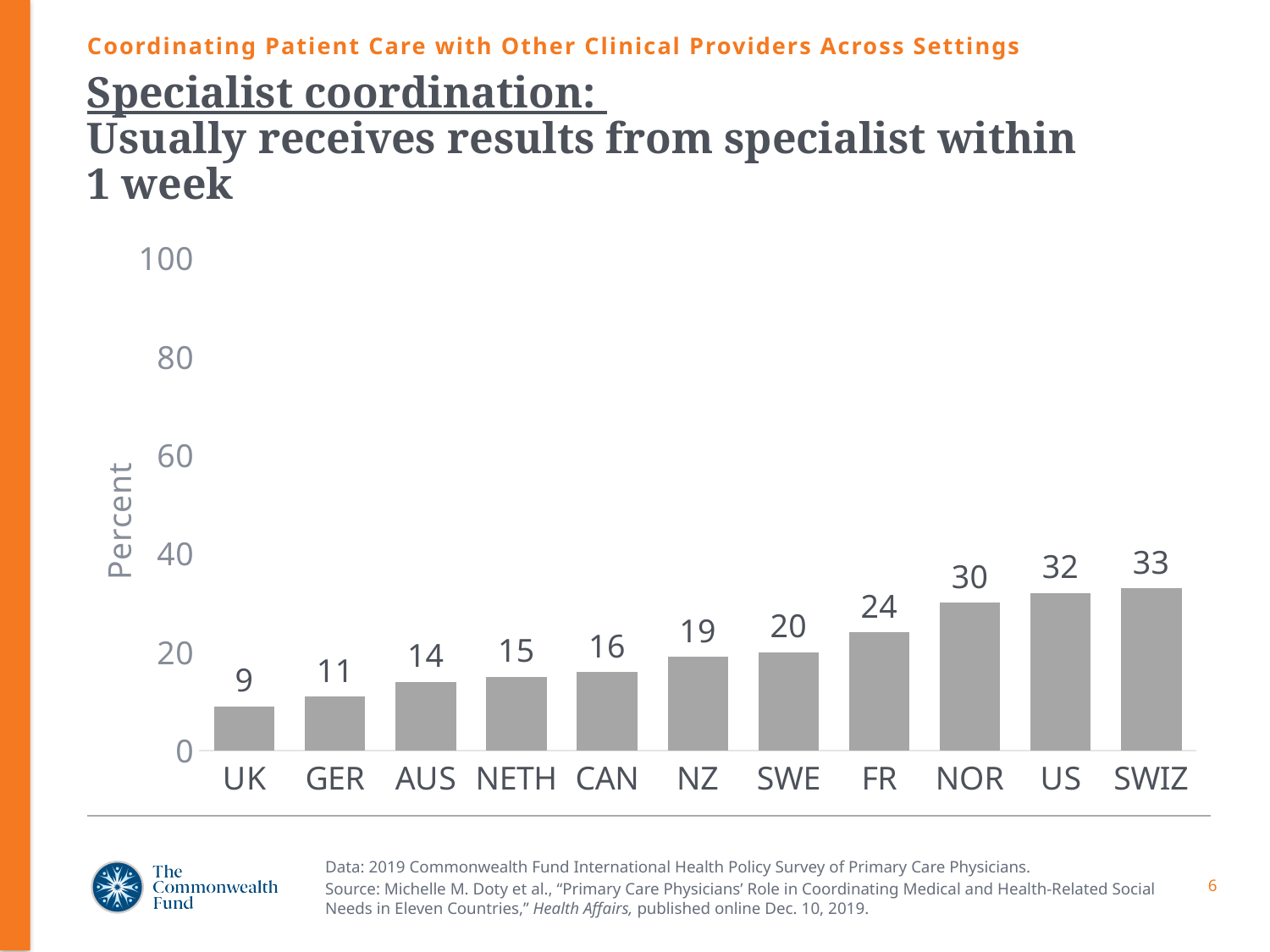
How many countries are shown on the chart? 11 Is the value for GER greater or less than 20? less What is the value for the US? 32 What is the value for NETH? 15 Do the values rise or fall from left to right along the x axis? rise Which country has the highest value? SWIZ What is the difference between the values for SWIZ and UK? 24 What is the value for FR? 24 What is the difference between the values for NOR and SWE? 10 Which has a larger value, CAN or NZ? NZ What kind of chart is shown on the slide? bar chart Which country has the lowest value? UK